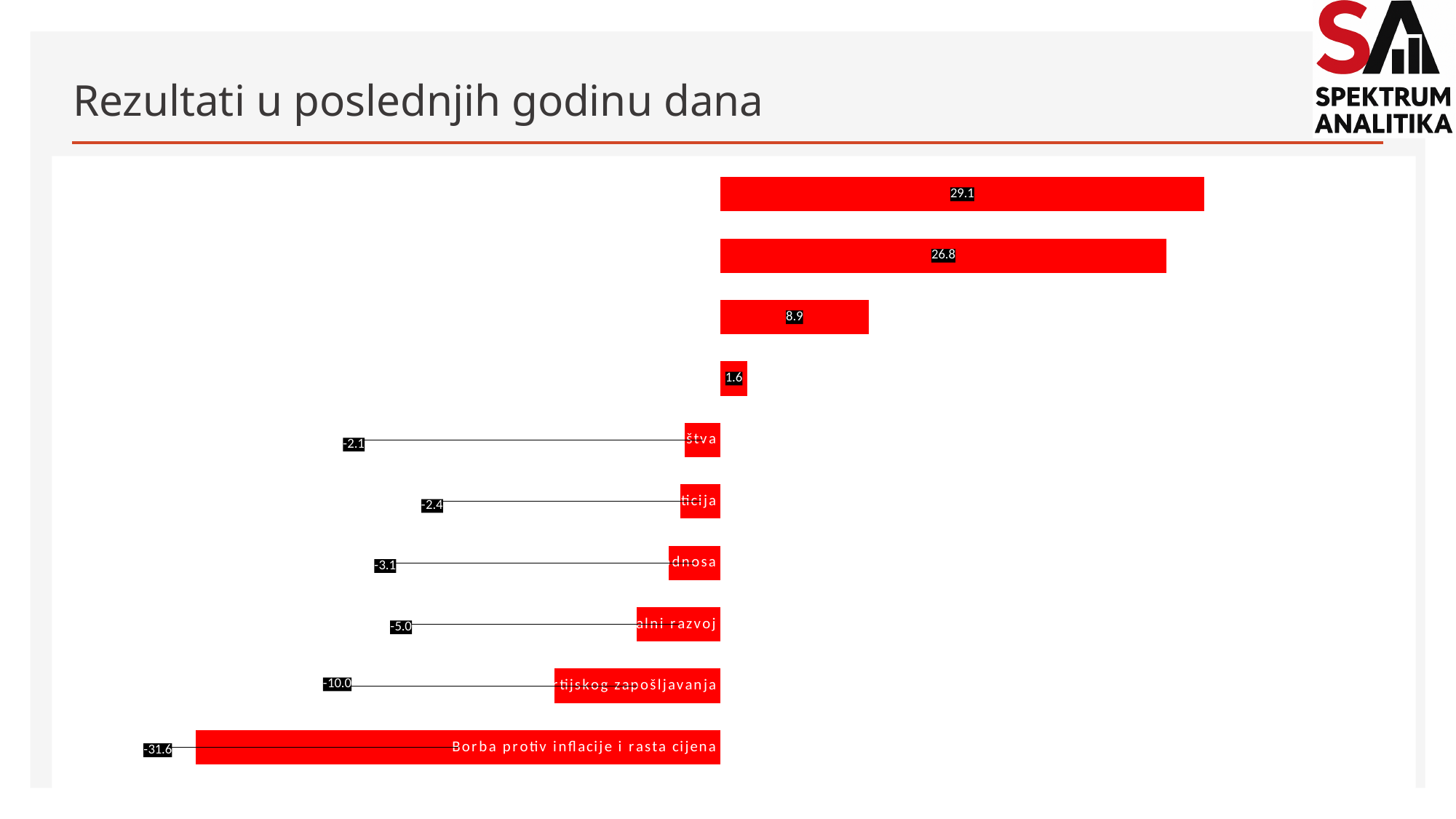
How many bars in the chart have negative values? 6 What colour are the bars in the chart? red What is the highest value shown in the chart? 29.1 What is the title of the slide containing the chart? Rezultati u poslednjih godinu dana What is the difference between the two largest values in the chart, 29.1 and 26.8? 2.3 How many bars are plotted in the chart? 10 What is the difference between the third bar from the top (8.9) and the fourth bar from the top (1.6)? 7.3 How many bars in the chart have positive values? 4 Is the value of the topmost bar larger or smaller than the value of the second bar from the top? larger What is the value for Borba protiv inflacije i rasta cijena? -31.6 Which category has the lowest value in the chart? Borba protiv inflacije i rasta cijena What kind of chart is shown on the slide? bar chart